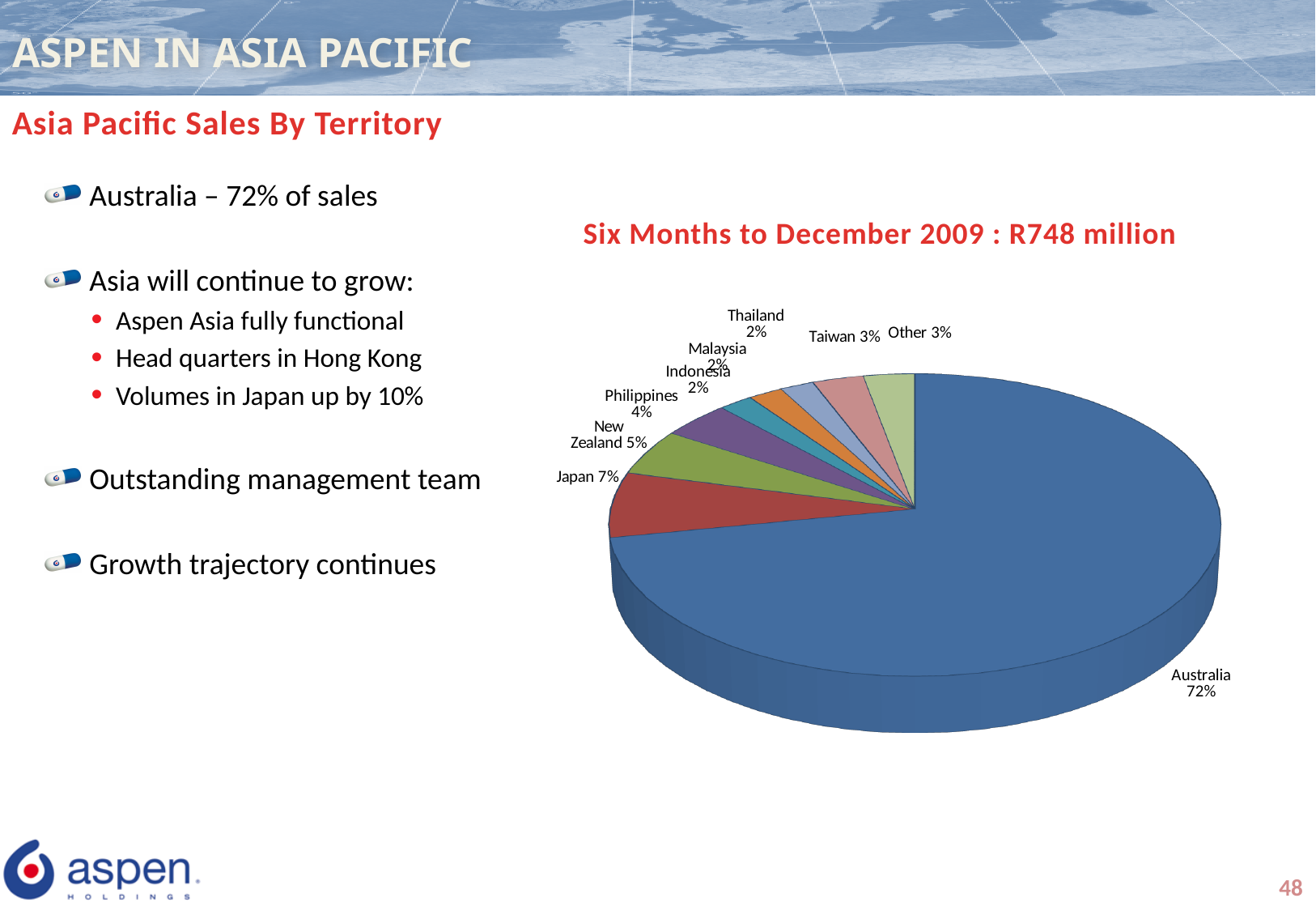
What is the combined share of Japan and New Zealand in the pie chart? 12% What share of Asia Pacific sales does Australia account for in the pie chart? 72% How many slices does the pie chart have? 9 What is the share shown for New Zealand in the pie chart? 5% What is the title shown above the pie chart? Six Months to December 2009 : R748 million What is the difference in percentage points between Australia's share and Japan's share in the pie chart? 65 What percentage of sales does Japan represent in the pie chart? 7% Which has a larger share in the pie chart, New Zealand or the Philippines? New Zealand What percentage is shown for the Philippines in the pie chart? 4% What type of chart is used to show Asia Pacific sales by territory? Pie chart Which territory has the largest slice in the pie chart? Australia What share of sales does Taiwan have in the pie chart? 3%